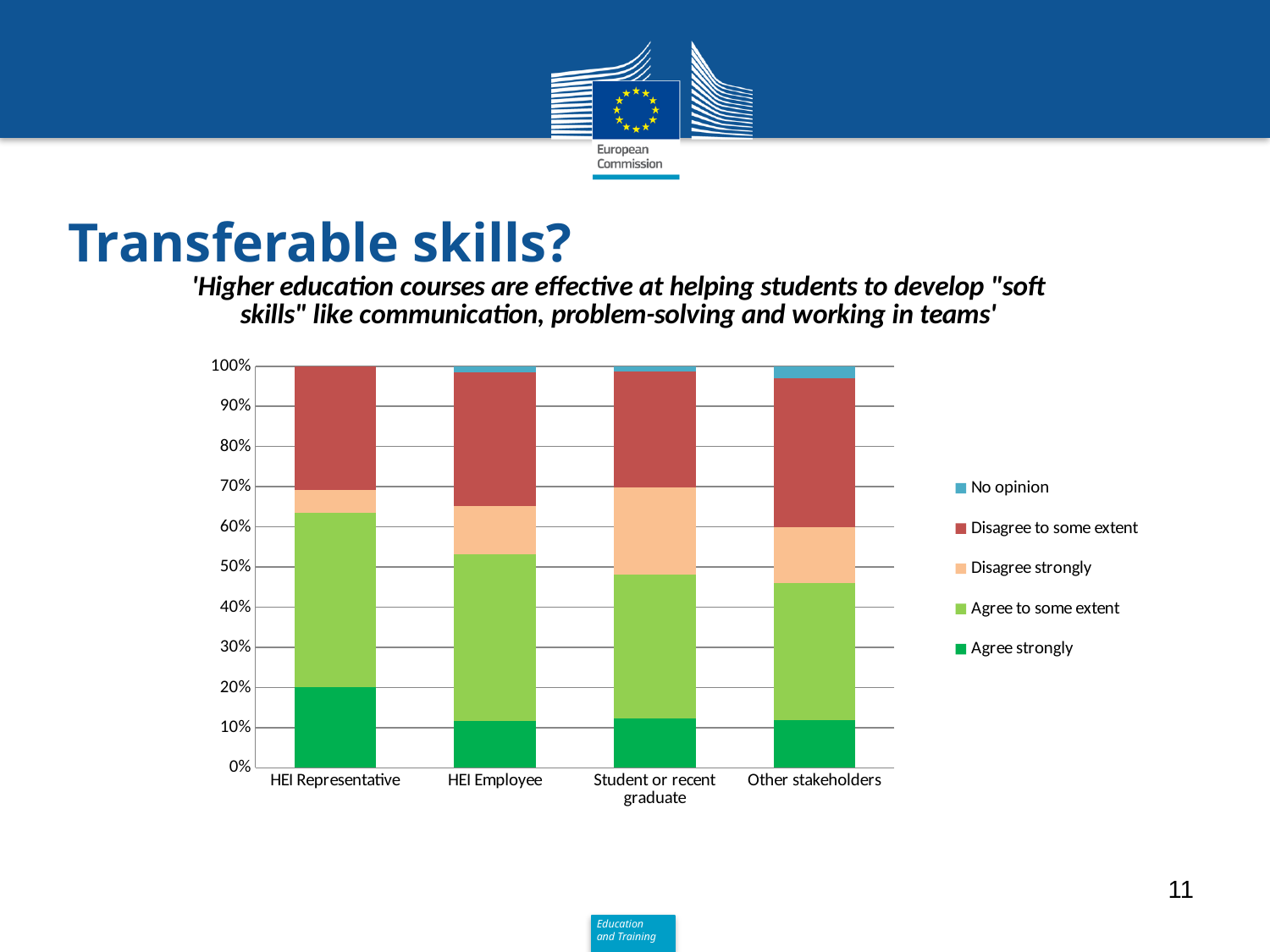
Is the 'Agree strongly' value for HEI Representative greater or less than 10%? greater What kind of chart is shown on the slide? Stacked bar chart Is the combined 'Agree strongly' and 'Agree to some extent' share for HEI Representative greater or less than 60%? greater What is the total of the stacked bar for HEI Employee? 100% Which category has the largest 'Agree strongly' segment? HEI Representative Which legend entry is shown in dark green? Agree strongly Which category has the largest 'Disagree strongly' segment? Student or recent graduate How many categories are shown on the x axis of the chart? 4 Which is larger: the 'Agree strongly' segment for HEI Representative or for HEI Employee? HEI Representative Which category has the largest 'No opinion' segment? Other stakeholders How many series does the chart's legend list? 5 Is the combined 'Agree strongly' and 'Agree to some extent' share for Student or recent graduate greater or less than 50%? less